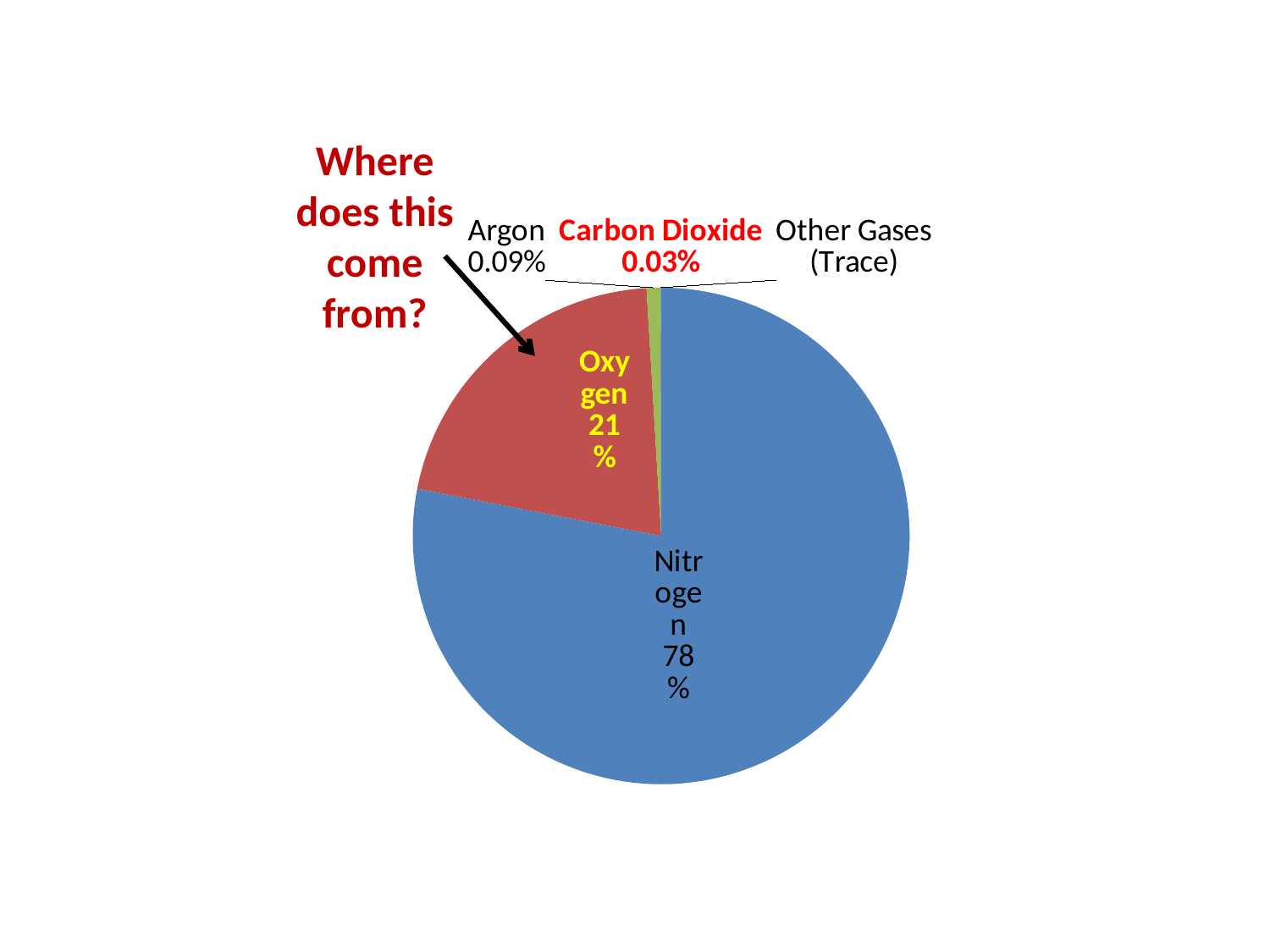
What percentage of the pie is Nitrogen? 78% What is the difference between the Argon and Carbon Dioxide percentages? 0.06% What percentage of the pie is Oxygen? 21% Which is larger, Argon or Carbon Dioxide? Argon What value is shown for Argon? 0.09% What colour is the Nitrogen slice? blue What kind of chart is shown on the slide? pie chart How many labelled slices does the pie chart have? 5 Which is larger, the Oxygen slice or the Nitrogen slice? Nitrogen What is the difference between the Nitrogen and Oxygen percentages? 57% What value is shown for Carbon Dioxide? 0.03% Which gas has the largest slice of the pie? Nitrogen